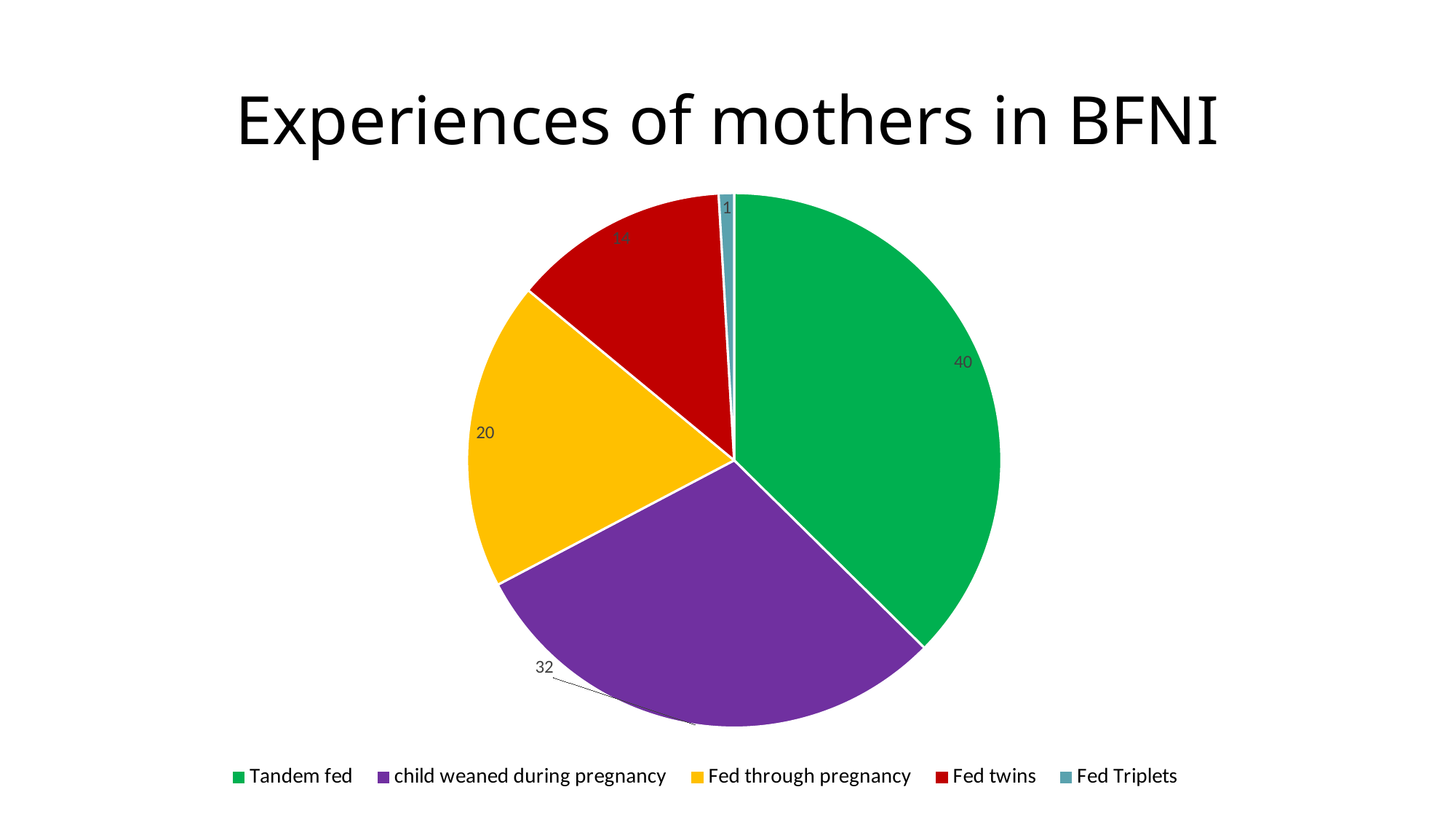
What is the value for Fed Triplets? 1 Which category has the smallest slice? Fed Triplets How many categories does the pie chart show? 5 What kind of chart is shown on the slide? Pie chart What is the title of the chart? Experiences of mothers in BFNI What is the value for child weaned during pregnancy? 32 What is the value for Fed through pregnancy? 20 What is the difference between the values for Tandem fed and child weaned during pregnancy? 8 Which is larger, Fed through pregnancy or Fed twins? Fed through pregnancy What is the value for Fed twins? 14 What is the value for Tandem fed? 40 Which category has the largest slice? Tandem fed